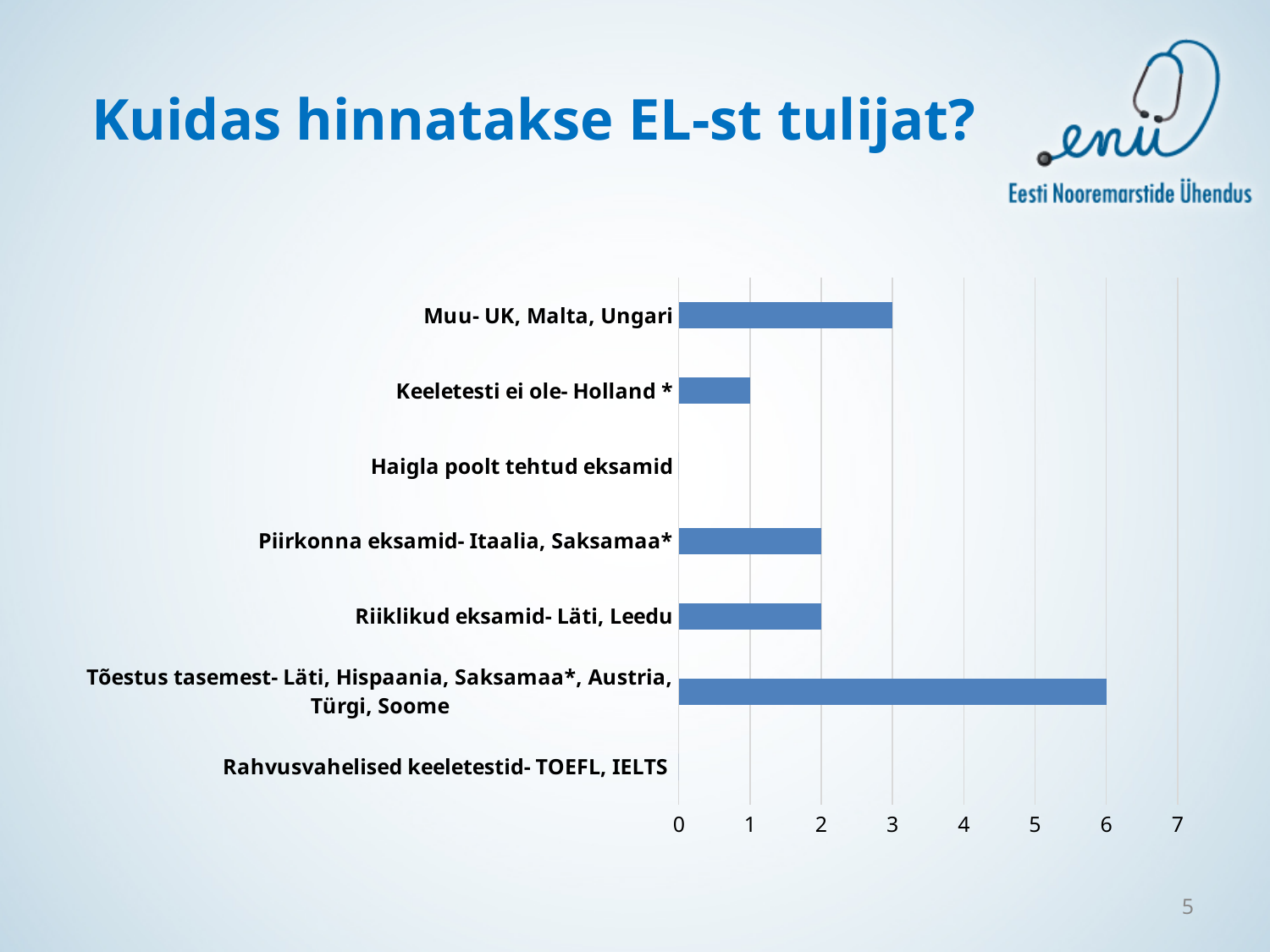
What is the highest value shown on the horizontal axis? 7 What is the title of the slide? Kuidas hinnatakse EL-st tulijat? What is the value for "Riiklikud eksamid- Läti, Leedu"? 2 What is the value for "Muu- UK, Malta, Ungari"? 3 How many categories are listed on the chart? 7 Is the value for "Tõestus tasemest- Läti, Hispaania, Saksamaa*, Austria, Türgi, Soome" greater or less than 5? greater What is the value for "Tõestus tasemest- Läti, Hispaania, Saksamaa*, Austria, Türgi, Soome"? 6 Which category has the highest value? Tõestus tasemest- Läti, Hispaania, Saksamaa*, Austria, Türgi, Soome Which is larger, the value for "Muu- UK, Malta, Ungari" or the value for "Piirkonna eksamid- Itaalia, Saksamaa*"? Muu- UK, Malta, Ungari What is the difference between the values for "Tõestus tasemest- Läti, Hispaania, Saksamaa*, Austria, Türgi, Soome" and "Muu- UK, Malta, Ungari"? 3 What kind of chart is shown on the slide? bar chart What is the value for "Keeletesti ei ole- Holland *"? 1